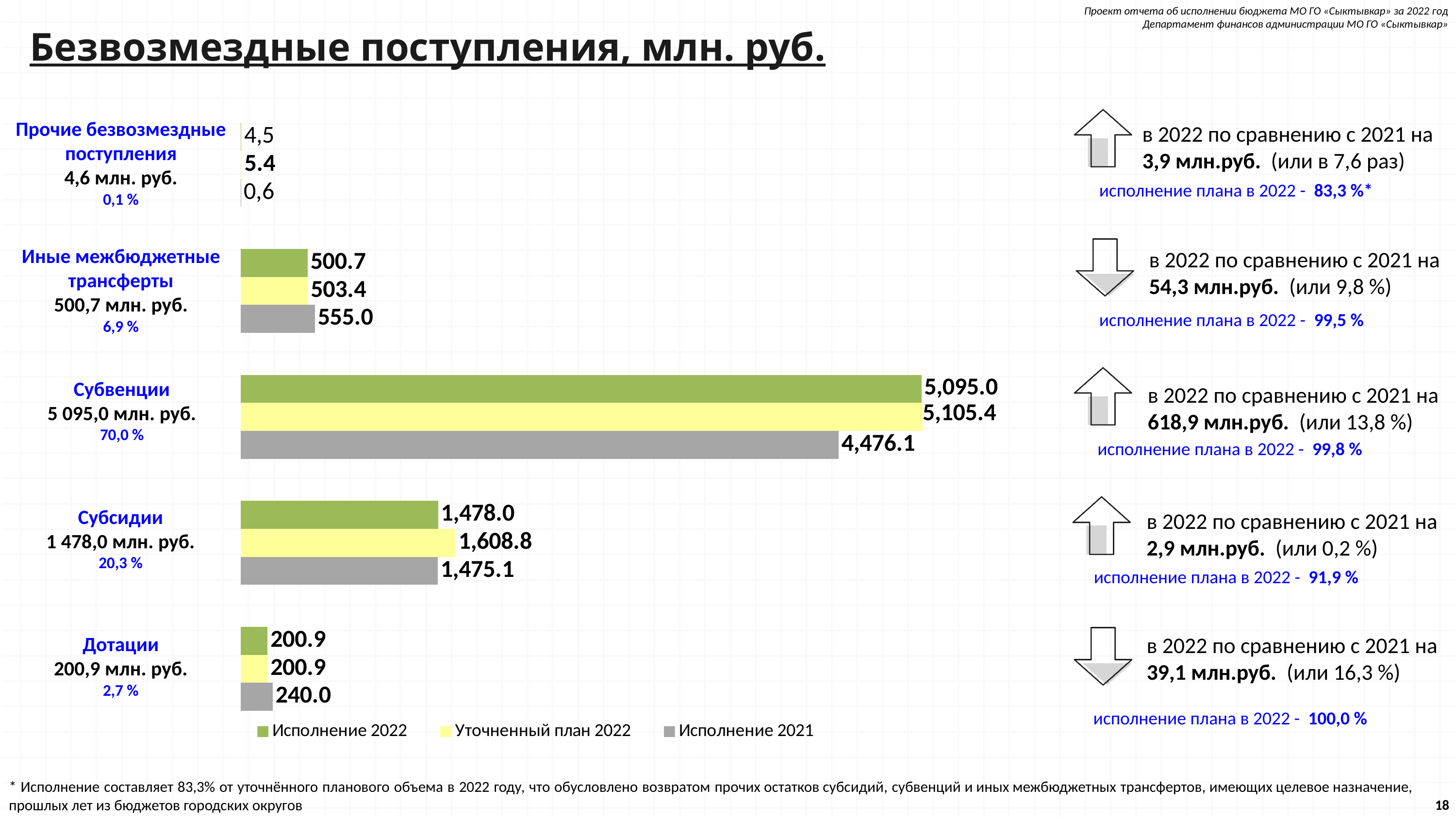
What is the value of Исполнение 2021 for Дотации? 240.0 Which category has the lowest Исполнение 2021 value? Прочие безвозмездные поступления What kind of chart is shown on the slide? Bar chart What is the value of Уточненный план 2022 for Субсидии? 1,608.8 How many series does the legend list? 3 What is the value of Исполнение 2021 for Иные межбюджетные трансферты? 555.0 What is the difference between Исполнение 2022 and Исполнение 2021 for Субвенции? 618.9 For Иные межбюджетные трансферты, which is larger: Исполнение 2022 or Исполнение 2021? Исполнение 2021 What is the difference between Уточненный план 2022 and Исполнение 2022 for Субсидии? 130.8 How many categories are shown in the chart? 5 Which category has the highest Исполнение 2022 value? Субвенции What is the value of Исполнение 2022 for Субвенции? 5,095.0